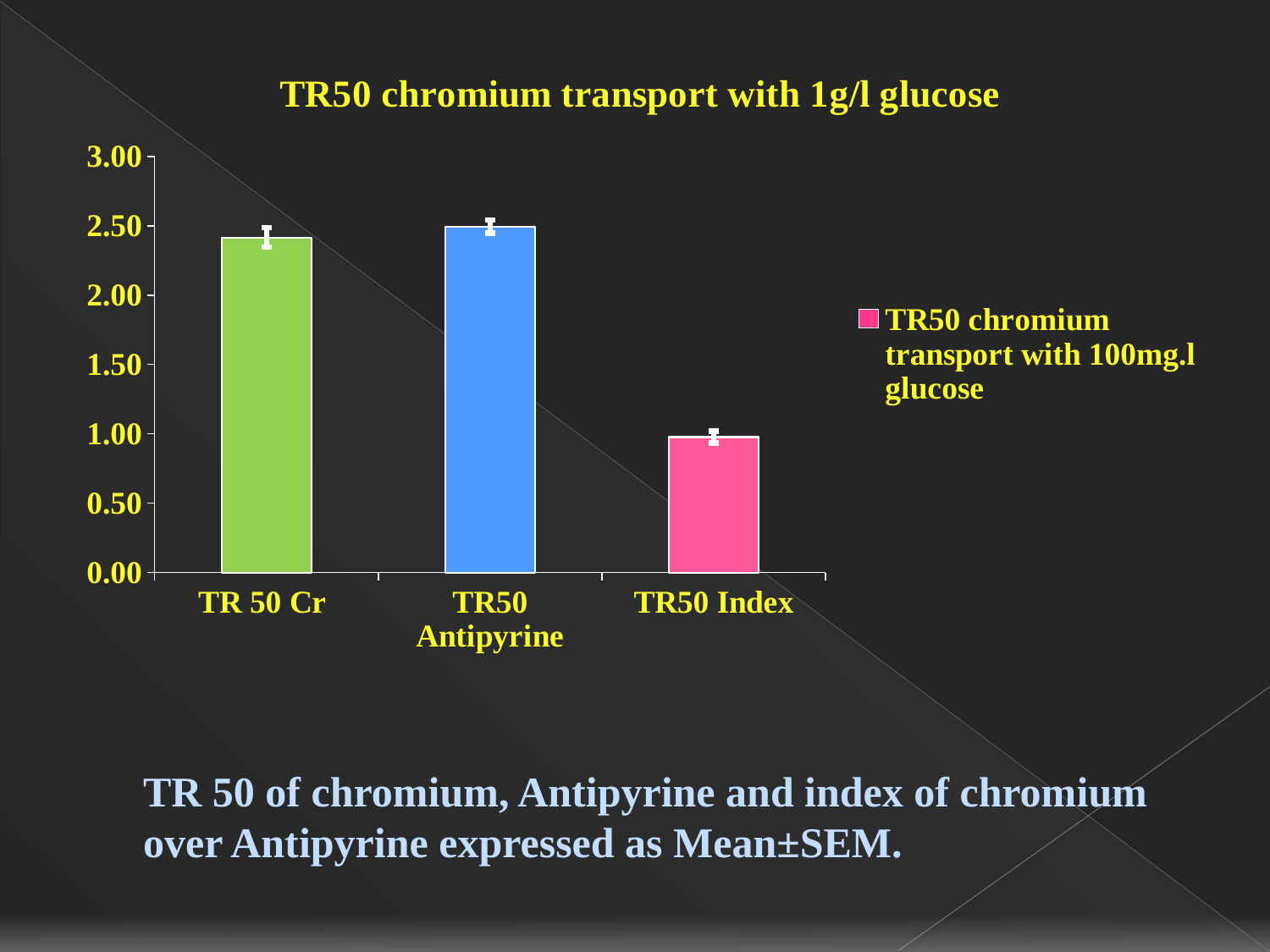
Is the value for TR50 Index greater or less than 0.50? greater Which category has the lowest value? TR50 Index How many categories are plotted on the x axis? 3 How many series does the legend list? 1 Is the value for TR50 Index greater or less than 1.50? less What kind of chart is shown on the slide? bar chart What is the title of the chart? TR50 chromium transport with 1g/l glucose Which is larger, the value for TR50 Antipyrine or the value for TR50 Index? TR50 Antipyrine Which is larger, the value for TR 50 Cr or the value for TR50 Index? TR 50 Cr What colour is the bar for TR50 Index? pink Is the value for TR50 Antipyrine greater or less than 2.00? greater